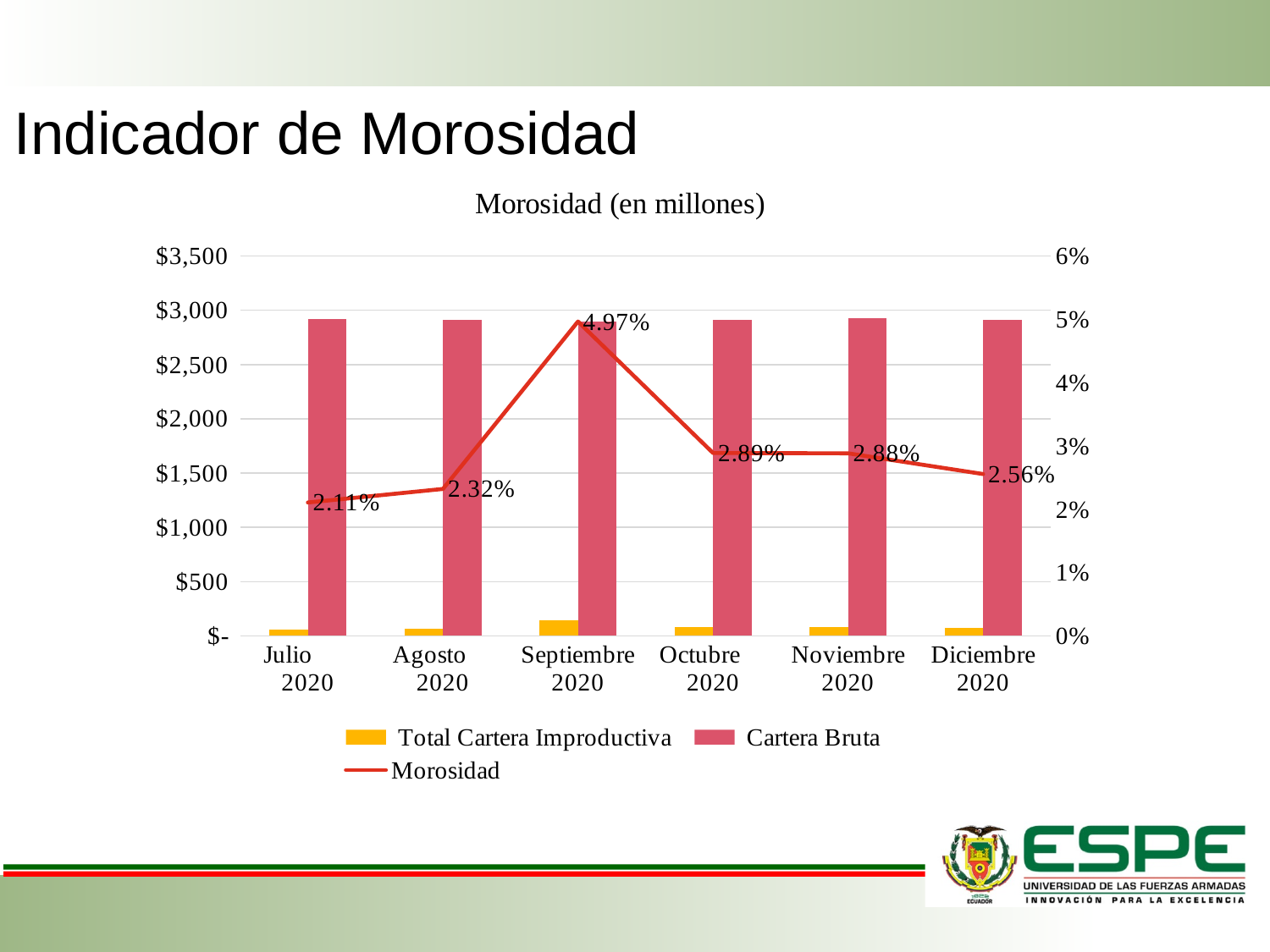
In which month is the Morosidad highest? Septiembre 2020 What is the Morosidad value for Septiembre 2020? 4.97% Is the Cartera Bruta value for Octubre 2020 greater or less than $2,500? greater What is the Morosidad value for Julio 2020? 2.11% How many series does the legend list? 3 In which month is the Morosidad lowest? Julio 2020 Which month has a higher Morosidad, Agosto 2020 or Diciembre 2020? Diciembre 2020 What is the Morosidad value for Diciembre 2020? 2.56% Is the Total Cartera Improductiva value for Septiembre 2020 greater or less than $500? less What is the difference between the Morosidad in Septiembre 2020 and Octubre 2020? 2.08 percentage points How many months are shown on the x axis? 6 What is the title of the chart? Morosidad (en millones)